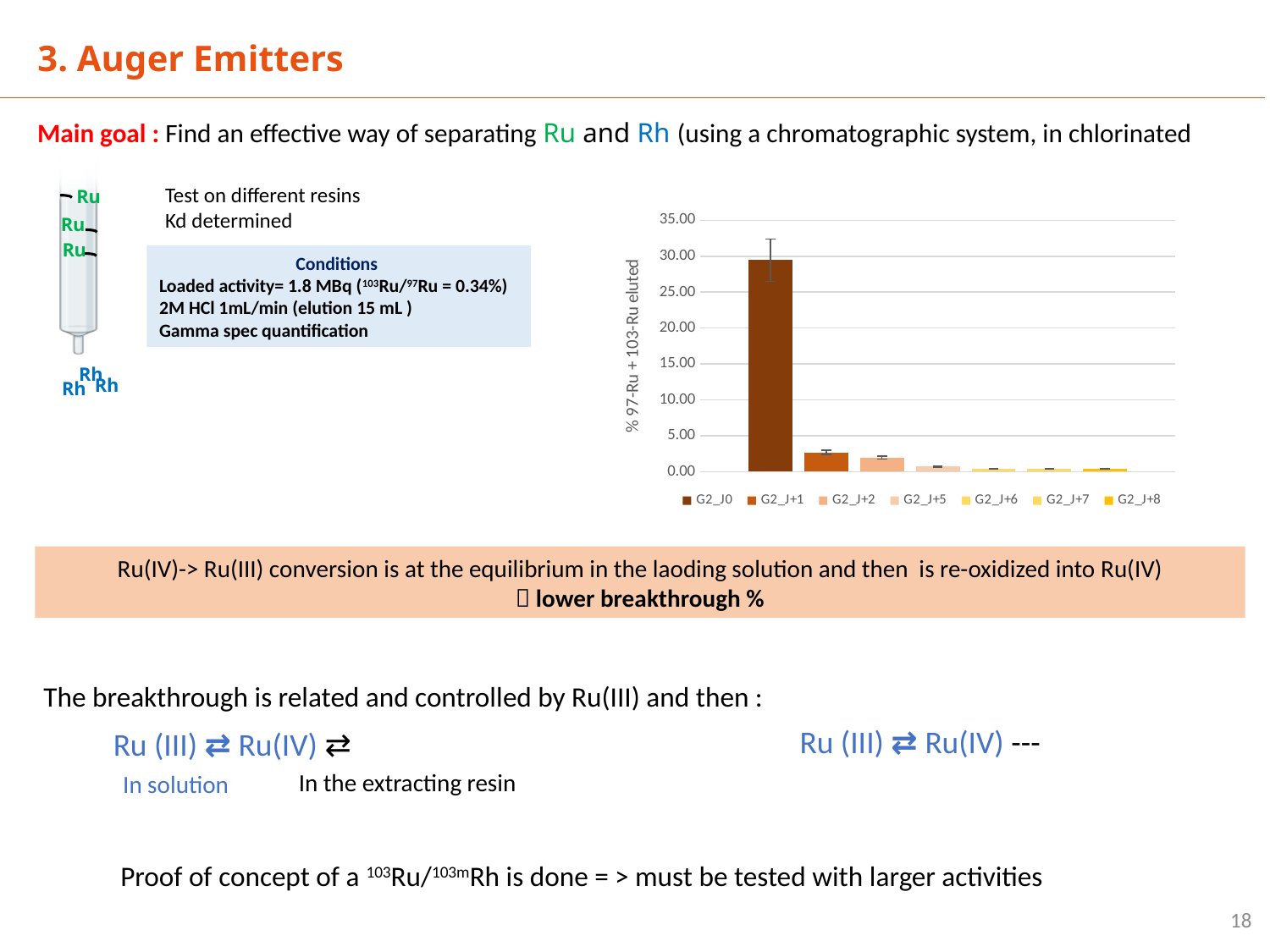
Which series has the highest value in the chart? G2_J0 What is the label on the chart's vertical axis? % 97-Ru + 103-Ru eluted Which is larger, the value for G2_J0 or the value for G2_J+1? G2_J0 Is the value for G2_J0 greater or less than 25.00? greater How many series does the chart's legend list? 7 Is the value for G2_J+1 greater or less than 5.00? less How many bars are plotted in the chart? 7 Do the bar values rise or fall from G2_J0 to G2_J+8 along the x axis? fall What is the first entry listed in the chart's legend? G2_J0 Which is larger, the value for G2_J+1 or the value for G2_J+5? G2_J+1 What kind of chart is shown on the slide? bar chart Is the value for G2_J+5 greater or less than 5.00? less